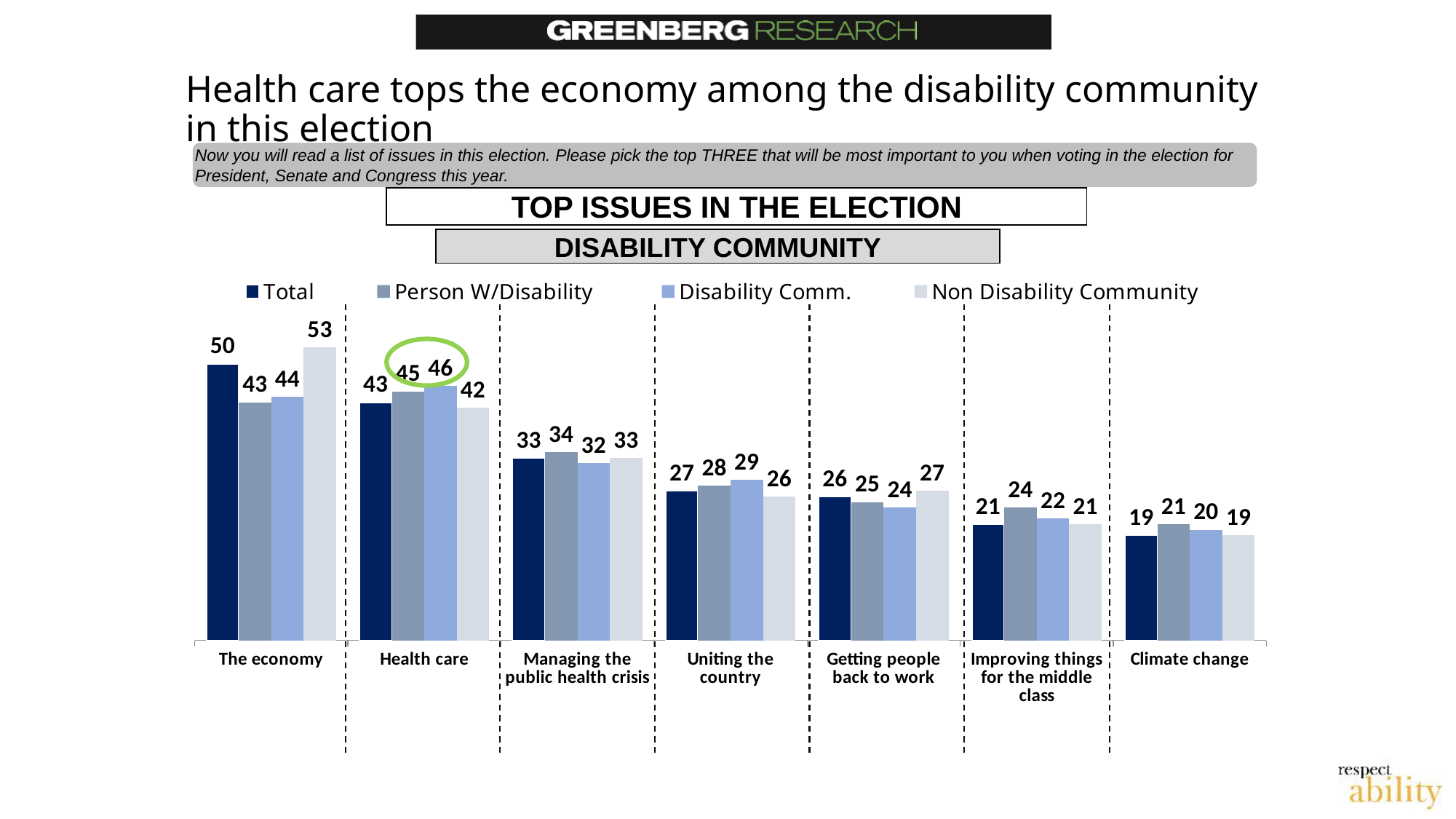
What kind of chart is shown on the slide? Bar chart How many series does the legend list? 4 For Health care, which is larger: the Disability Comm. value or the Non Disability Community value? Disability Comm. What is the Non Disability Community value for Climate change? 19 Which category has the highest Non Disability Community value? The economy Which series is shown in the darkest blue colour? Total Which category has the lowest Total value? Climate change How many issue categories are shown on the x axis? 7 What is the difference between the Non Disability Community value and the Total value for The economy? 3 What is the Total value for The economy? 50 Do the Total values generally rise or fall from The economy to Climate change? Fall What is the Disability Comm. value for Health care? 46